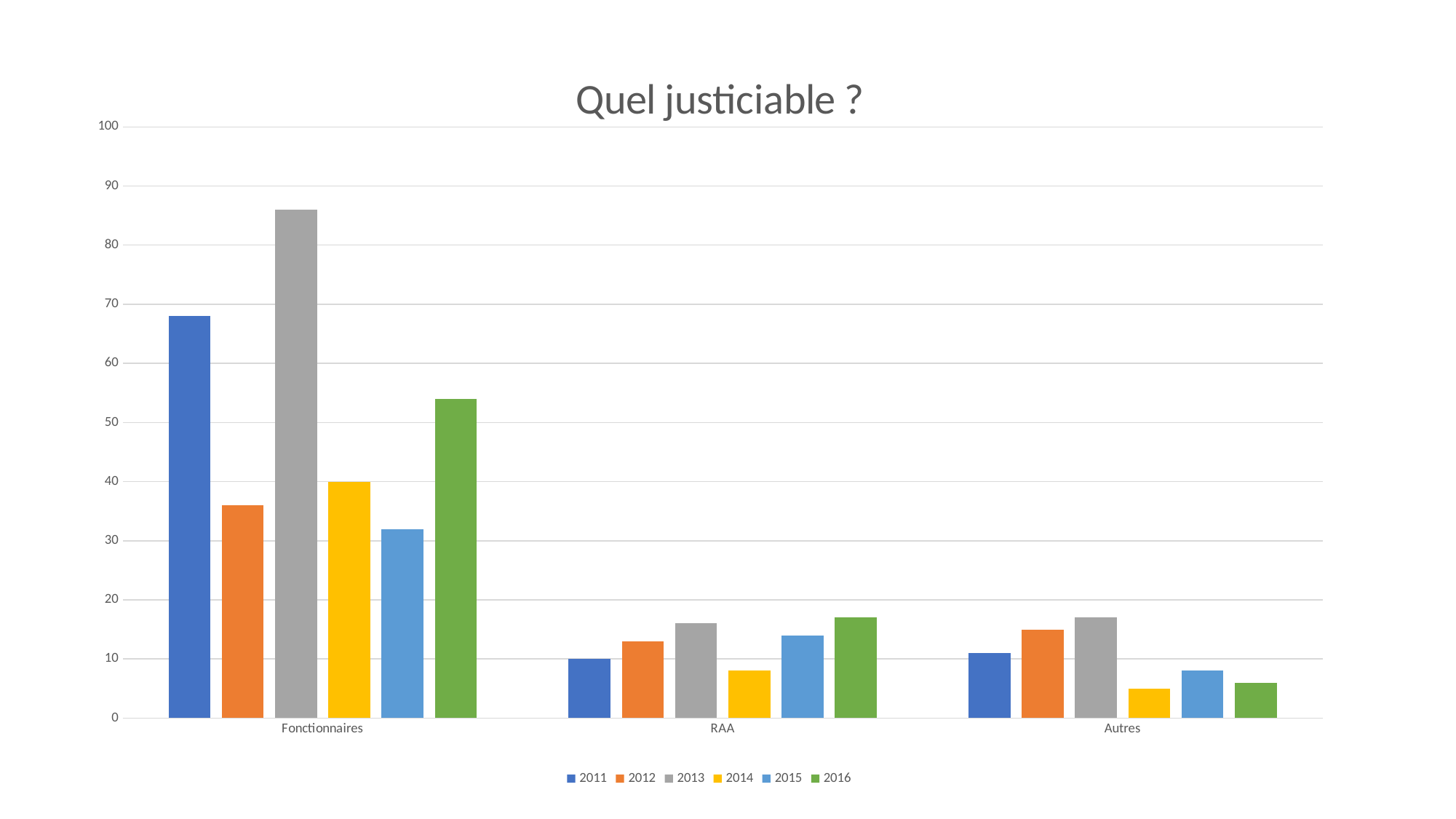
Is the value for 2013 in the Fonctionnaires category greater or less than 80? greater How many series does the legend list? 6 Which year has the lowest value for Autres? 2014 Which is larger for RAA: the value for 2012 or the value for 2016? 2016 Which year has the highest value for Fonctionnaires? 2013 Is the value for 2014 in the RAA category greater or less than 10? less Which year has the lowest value for Fonctionnaires? 2015 What kind of chart is shown on the slide? bar chart How many categories are shown on the x axis? 3 What is the title of the chart? Quel justiciable ? Which category has the highest value for 2011? Fonctionnaires Is the value for 2016 in the Fonctionnaires category greater or less than 50? greater